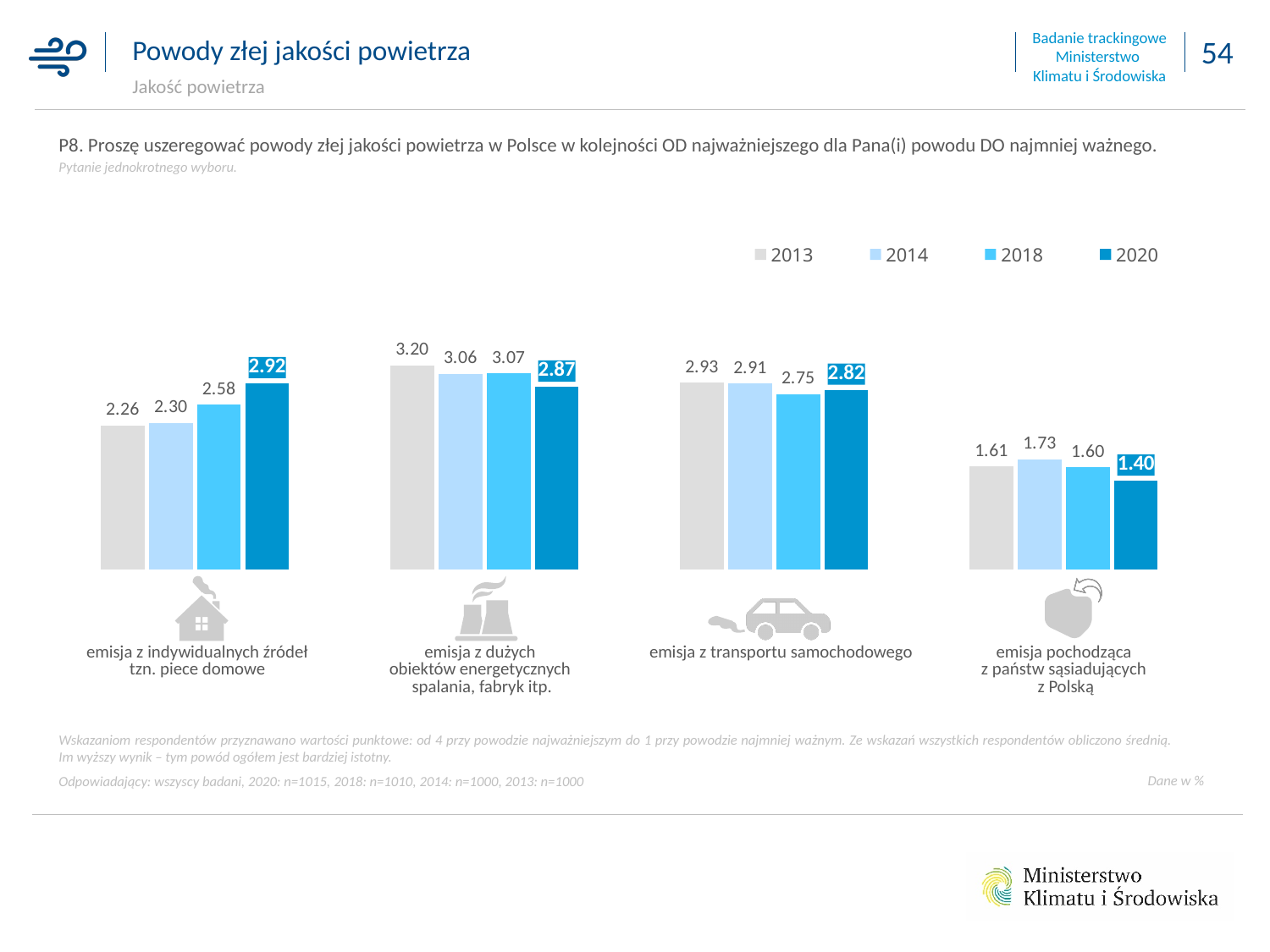
What is the 2020 value for "emisja z indywidualnych źródeł tzn. piece domowe"? 2.92 Which is larger for "emisja z dużych obiektów energetycznych spalania, fabryk itp.": the 2013 value or the 2020 value? 2013 What kind of chart is shown on the slide? bar chart Which category has the lowest 2013 value? emisja pochodząca z państw sąsiadujących z Polską What is the 2013 value for "emisja z dużych obiektów energetycznych spalania, fabryk itp."? 3.20 Do the values for "emisja z indywidualnych źródeł tzn. piece domowe" rise or fall from 2013 to 2020? rise How many categories are shown on the chart? 4 How many series does the legend list? 4 What is the difference between the 2020 and 2013 values for "emisja z indywidualnych źródeł tzn. piece domowe"? 0.66 Which category has the highest 2020 value? emisja z indywidualnych źródeł tzn. piece domowe What is the 2014 value for "emisja pochodząca z państw sąsiadujących z Polską"? 1.73 What is the 2018 value for "emisja z transportu samochodowego"? 2.75